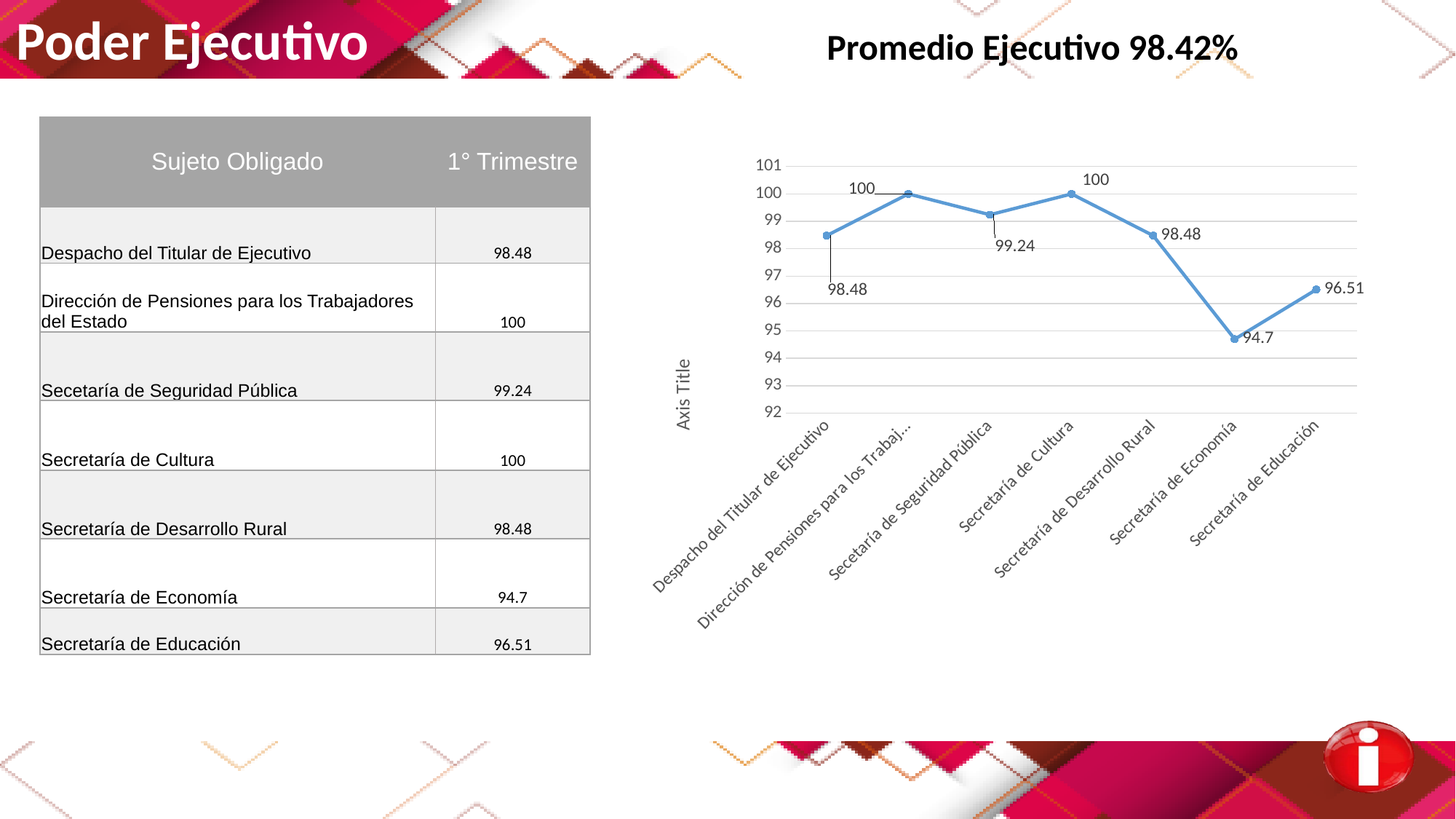
What is the difference between the values for Secretaría de Cultura and Secretaría de Economía? 5.3 Which is larger, the value for Secretaría de Desarrollo Rural or the value for Secretaría de Educación? Secretaría de Desarrollo Rural Does the line rise or fall between Secretaría de Desarrollo Rural and Secretaría de Economía? fall What is the label shown on the vertical axis of the chart? Axis Title What is the value for Secretaría de Economía in the chart? 94.7 What is the value for Despacho del Titular de Ejecutivo in the chart? 98.48 What is the value for Secretaría de Educación in the chart? 96.51 Which category has the lowest value in the chart? Secretaría de Economía How many categories are plotted on the x axis of the chart? 7 Is the value for Secretaría de Economía greater or less than 95? less What kind of chart is shown on the slide? line chart What is the value for Secretaría de Seguridad Pública in the chart? 99.24